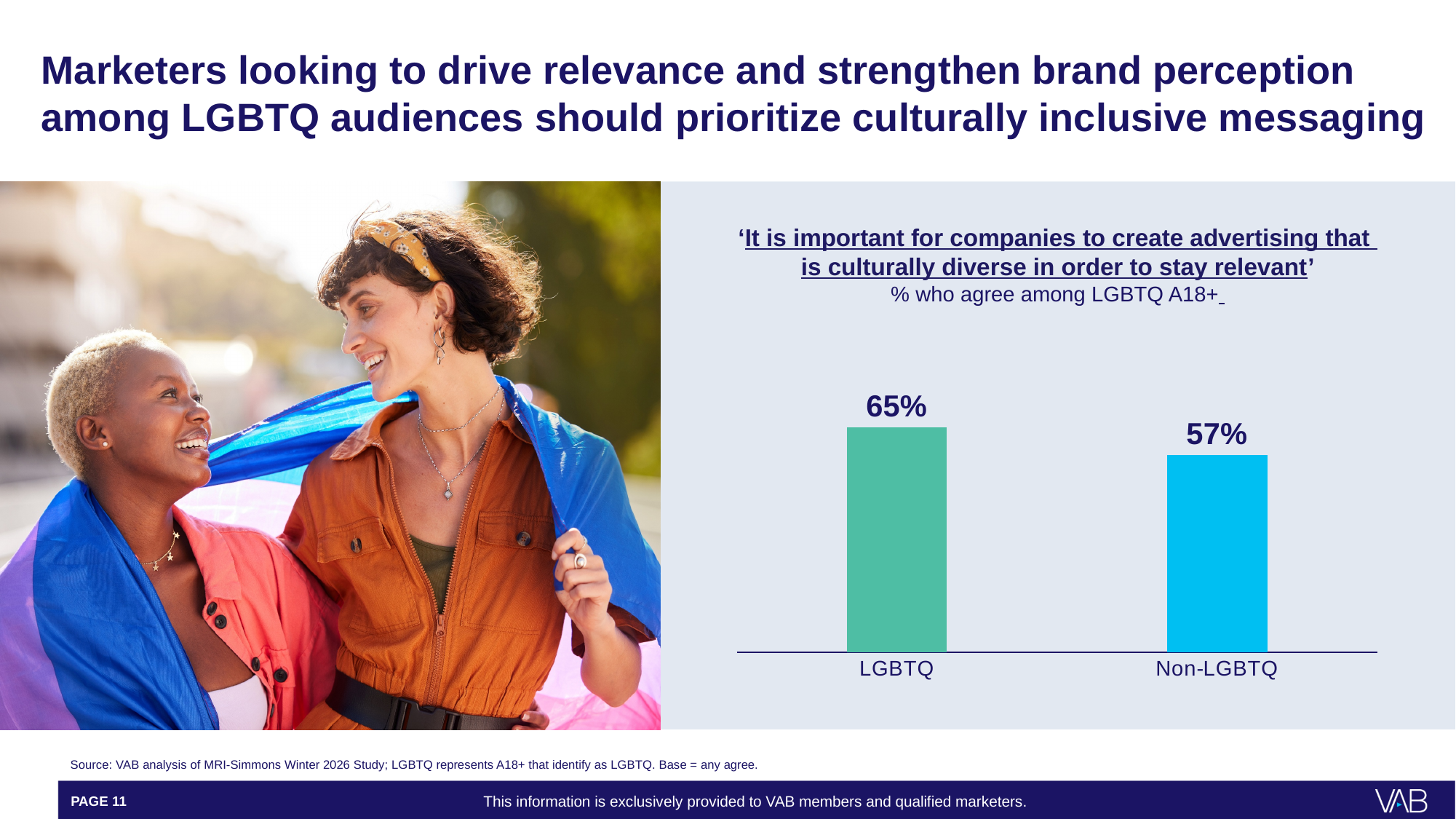
Is the value for LGBTQ larger or smaller than the value for Non-LGBTQ? larger How many categories are shown in the chart? 2 What percentage of Non-LGBTQ respondents agree with the statement in the chart? 57% Which group has the higher share of agreement in the chart? LGBTQ What is the difference in percentage points between the LGBTQ and Non-LGBTQ bars? 8 percentage points What colour is the Non-LGBTQ bar in the chart? blue What kind of chart is shown on the slide? bar chart Which group has the lower share of agreement in the chart? Non-LGBTQ What percentage of LGBTQ respondents agree that it is important for companies to create culturally diverse advertising? 65% What colour is the LGBTQ bar in the chart? green